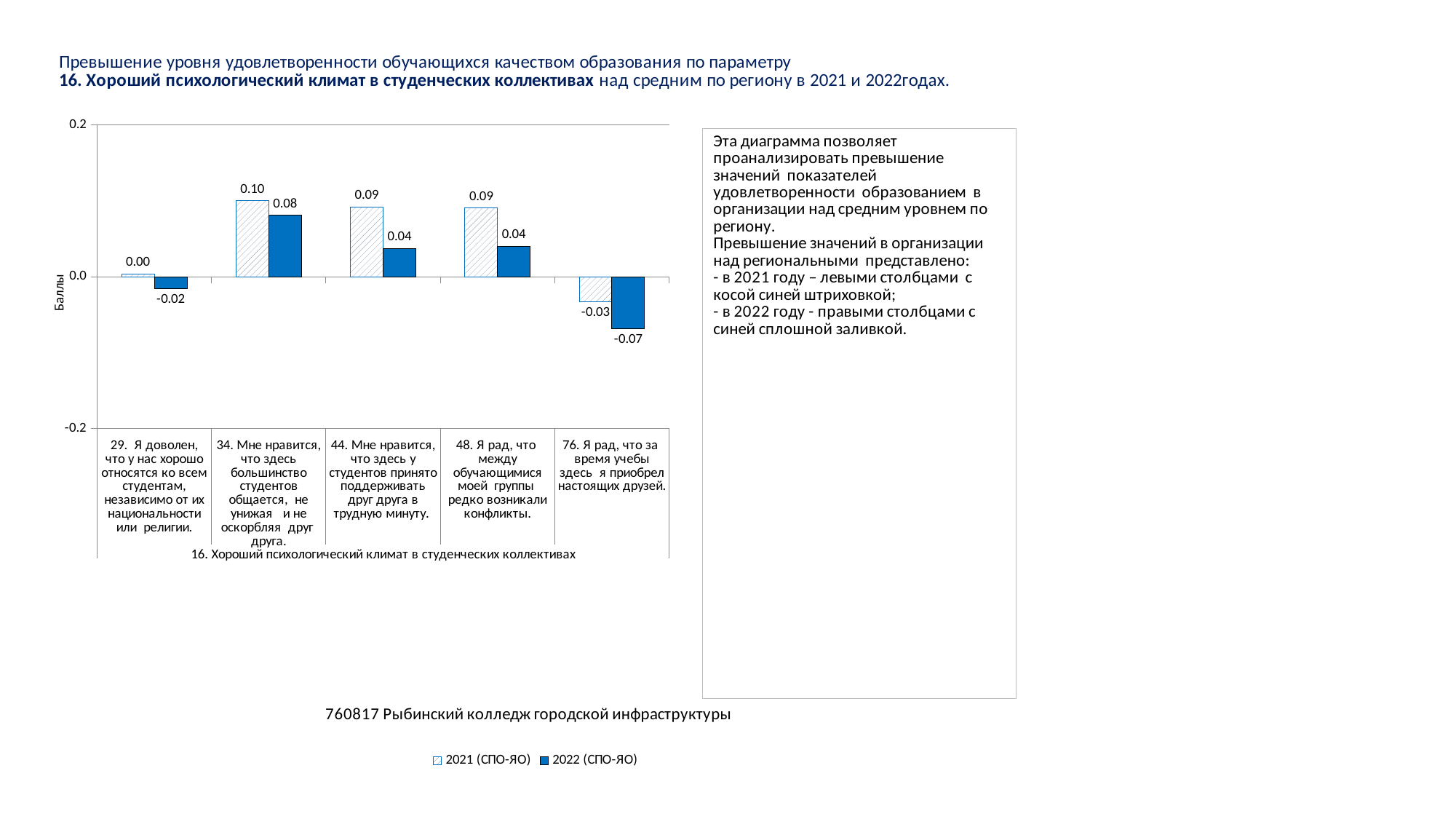
What is the difference between the 2021 and 2022 values for category 44? 0.05 What is the 2021 (СПО-ЯО) value for category 44 ("Мне нравится, что здесь у студентов принято поддерживать друг друга в трудную минуту")? 0.09 What kind of chart is shown on the slide? Bar chart How many categories are shown on the x axis of the chart? 5 How many series does the legend list? 2 Which category has the lowest 2022 (СПО-ЯО) value? 76. Я рад, что за время учебы здесь я приобрел настоящих друзей. What is the label of the vertical axis? Баллы What is the 2022 (СПО-ЯО) value for category 76 ("Я рад, что за время учебы здесь я приобрел настоящих друзей")? -0.07 Which category has the highest 2021 (СПО-ЯО) value? 34. Мне нравится, что здесь большинство студентов общается, не унижая и не оскорбляя друг друга. What is the 2021 (СПО-ЯО) value for category 34 ("Мне нравится, что здесь большинство студентов общается, не унижая и не оскорбляя друг друга")? 0.10 What is the 2022 (СПО-ЯО) value for category 29 ("Я доволен, что у нас хорошо относятся ко всем студентам...")? -0.02 For category 48, which series has the larger value, 2021 (СПО-ЯО) or 2022 (СПО-ЯО)? 2021 (СПО-ЯО)